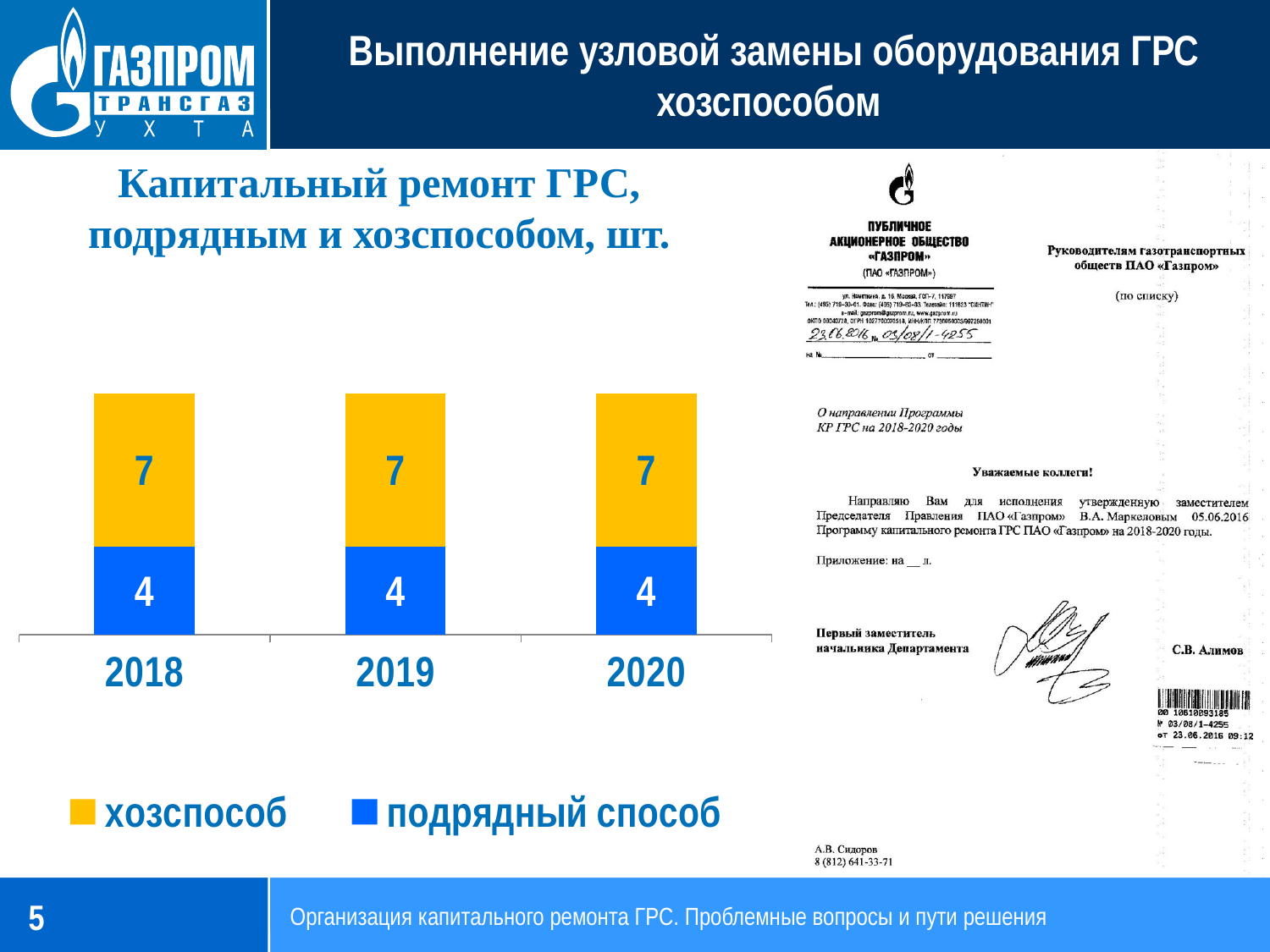
How many series does the legend list? 2 What kind of chart is shown on the slide? stacked bar chart How many years are shown on the x axis of the chart? 3 Do the values for подрядный способ rise, fall or stay the same from 2018 to 2020? stay the same What is the total of the stacked bar for 2020? 11 What is the value for хозспособ in 2019? 7 Which colour represents хозспособ in the chart? yellow What is the total of the stacked bar for 2019? 11 What is the value for подрядный способ in 2020? 4 What is the value for хозспособ in 2018? 7 Which is larger in 2020, хозспособ or подрядный способ? хозспособ What is the difference between хозспособ and подрядный способ in 2018? 3